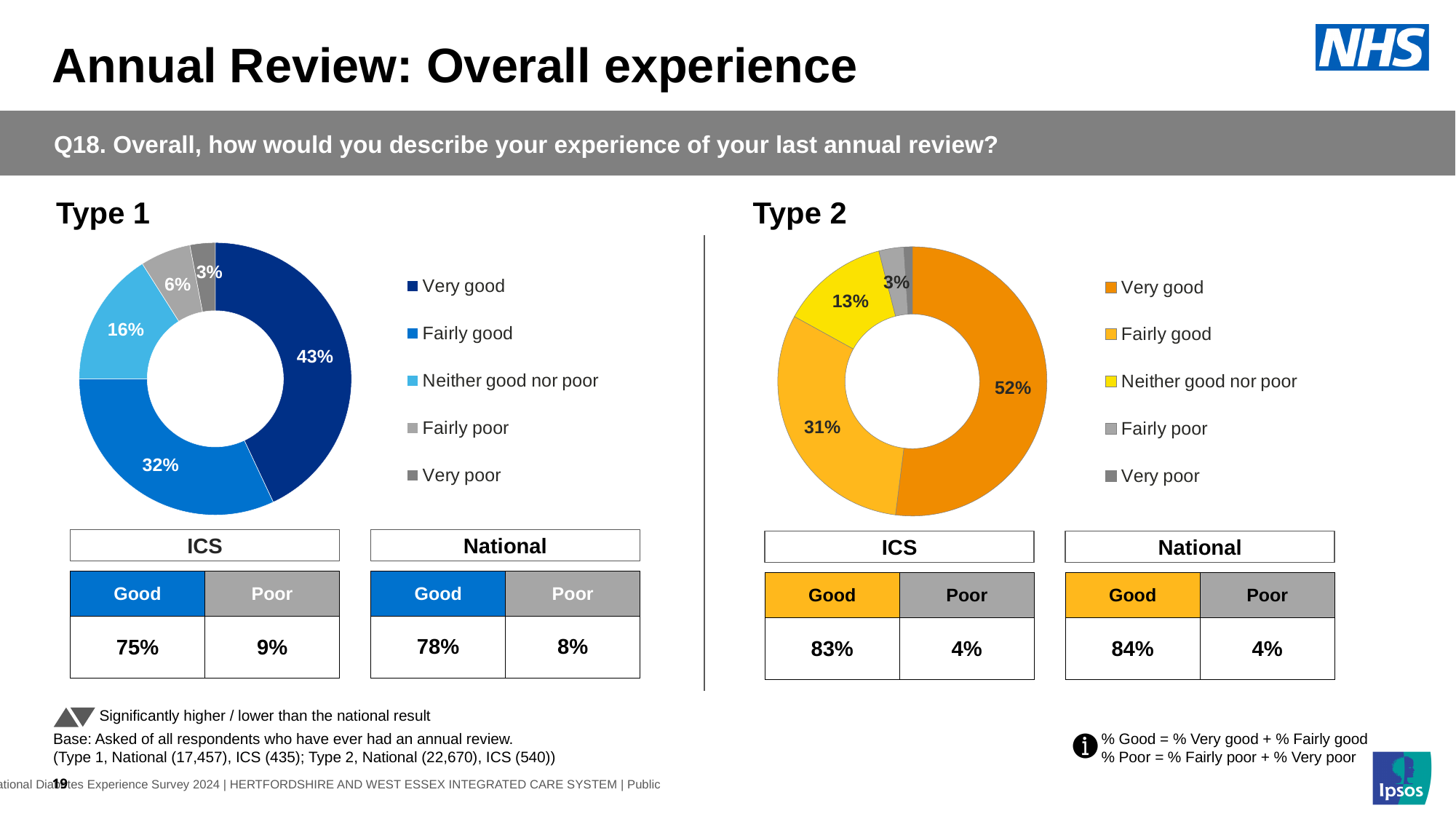
In the Type 2 chart, what percentage of respondents said their experience was Fairly good? 31% In the Type 1 chart, which response category has the largest share? Very good In the Type 1 chart, what percentage of respondents said their experience was Very good? 43% What kind of chart is used to show the Type 1 results? Donut (pie) chart In the Type 1 chart, which response category has the smallest share? Very poor In the Type 1 chart, what is the difference between the Very good and Fairly good percentages? 11% Which chart has the larger Very good share, Type 1 or Type 2? Type 2 In the Type 2 chart, what percentage of respondents said Neither good nor poor? 13% How many response categories does the legend of the Type 2 chart list? 5 In the Type 1 chart, what colour represents Very good? Dark blue In the Type 1 chart, what percentage of respondents said Neither good nor poor? 16% In the Type 2 chart, what is the difference between the Very good and Fairly good percentages? 21%